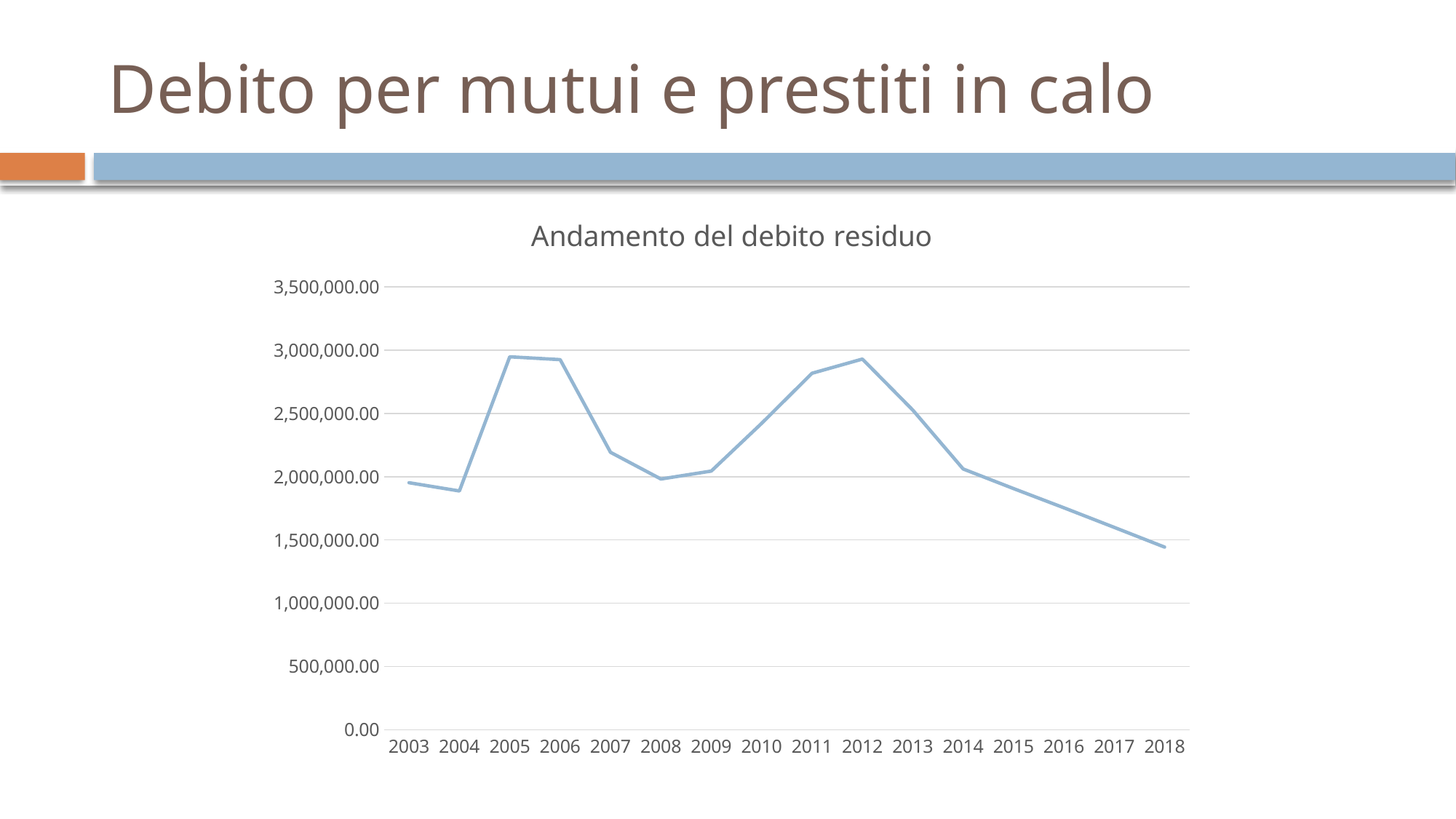
Which is larger, the value for 2003 or the value for 2018? 2003 Do the values rise or fall from 2012 to 2018? fall Is the value for 2004 greater or less than 2,000,000.00? less Which is larger, the value for 2005 or the value for 2004? 2005 Do the values rise or fall from 2008 to 2012? rise Which year has the lowest value on the chart? 2018 Is the value for 2005 greater or less than 2,500,000.00? greater Is the value for 2016 greater or less than 2,000,000.00? less What is the title of the chart? Andamento del debito residuo How many years are plotted along the x axis? 16 What kind of chart is shown on the slide? line chart